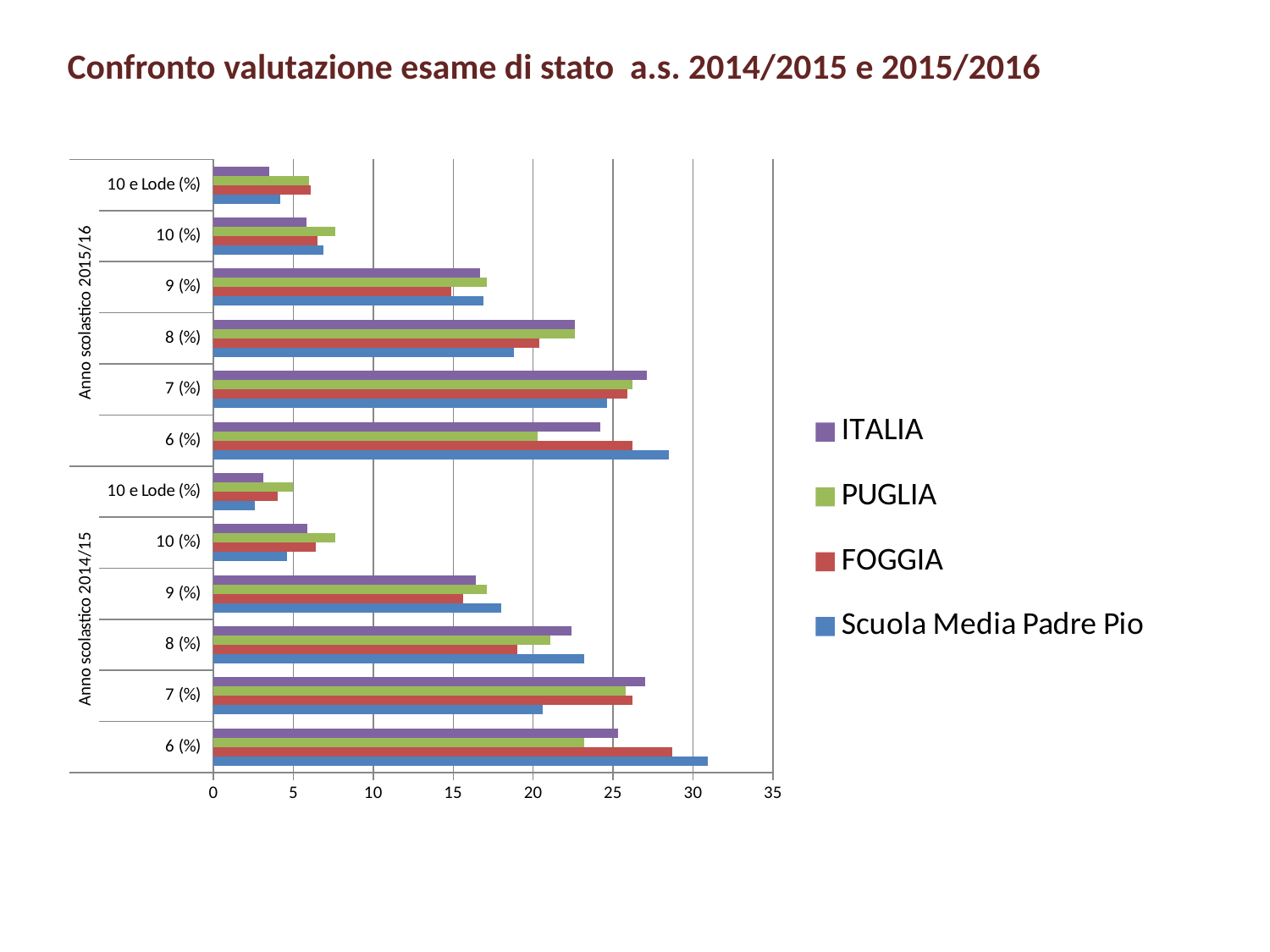
For 6 (%) in Anno scolastico 2015/16, which is larger: PUGLIA or FOGGIA? FOGGIA What is the title of the slide? Confronto valutazione esame di stato a.s. 2014/2015 e 2015/2016 Is the value for PUGLIA at 8 (%) in Anno scolastico 2015/16 greater or less than 20? greater How many grade categories are plotted in total across both school years? 12 For 6 (%) in Anno scolastico 2014/15, which series has the highest value? Scuola Media Padre Pio For 10 e Lode (%) in Anno scolastico 2014/15, which series has the lowest value? Scuola Media Padre Pio What kind of chart is shown on the slide? Bar chart How many series does the legend list? 4 Which series are listed in the legend? ITALIA, PUGLIA, FOGGIA, Scuola Media Padre Pio Is the value for ITALIA at 10 e Lode (%) in Anno scolastico 2015/16 greater or less than 5? less Is the value for Scuola Media Padre Pio at 6 (%) in Anno scolastico 2014/15 greater or less than 30? greater For 7 (%) in Anno scolastico 2014/15, which is larger: ITALIA or Scuola Media Padre Pio? ITALIA